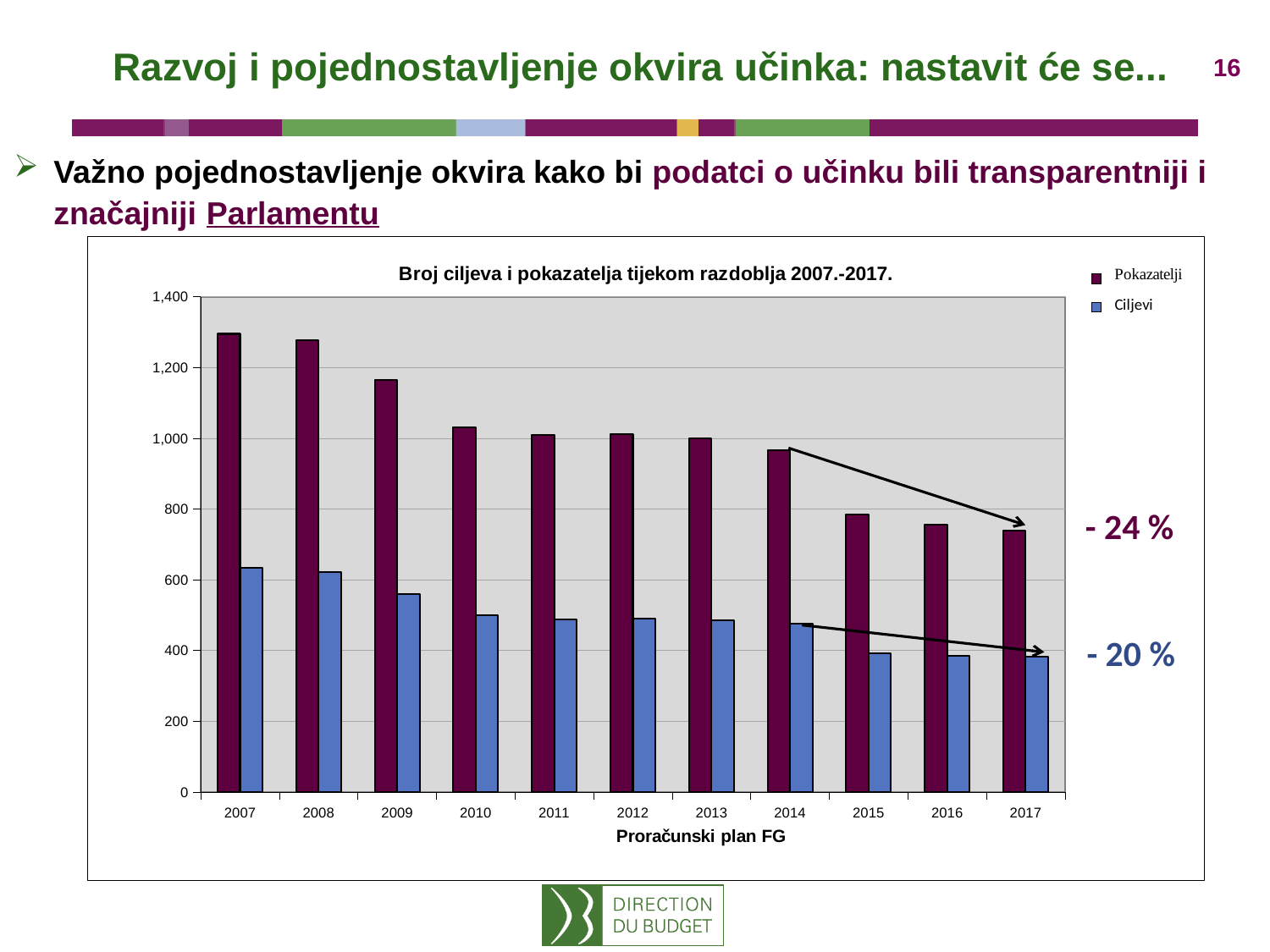
Is the Ciljevi value for 2009 greater or less than 600? less How many years are shown on the x axis of the chart? 11 What is the title of the chart? Broj ciljeva i pokazatelja tijekom razdoblja 2007.-2017. What percentage change is annotated next to the Pokazatelji series on the chart? - 24 % Is the Pokazatelji value for 2017 greater or less than 800? less Is the Pokazatelji value for 2007 greater or less than 1,200? greater What kind of chart is shown on the slide? bar chart In 2007, which series has the larger value, Pokazatelji or Ciljevi? Pokazatelji Do the Ciljevi values rise or fall from 2007 to 2017? fall Do the Pokazatelji values rise or fall from 2007 to 2017? fall How many series does the chart legend list? 2